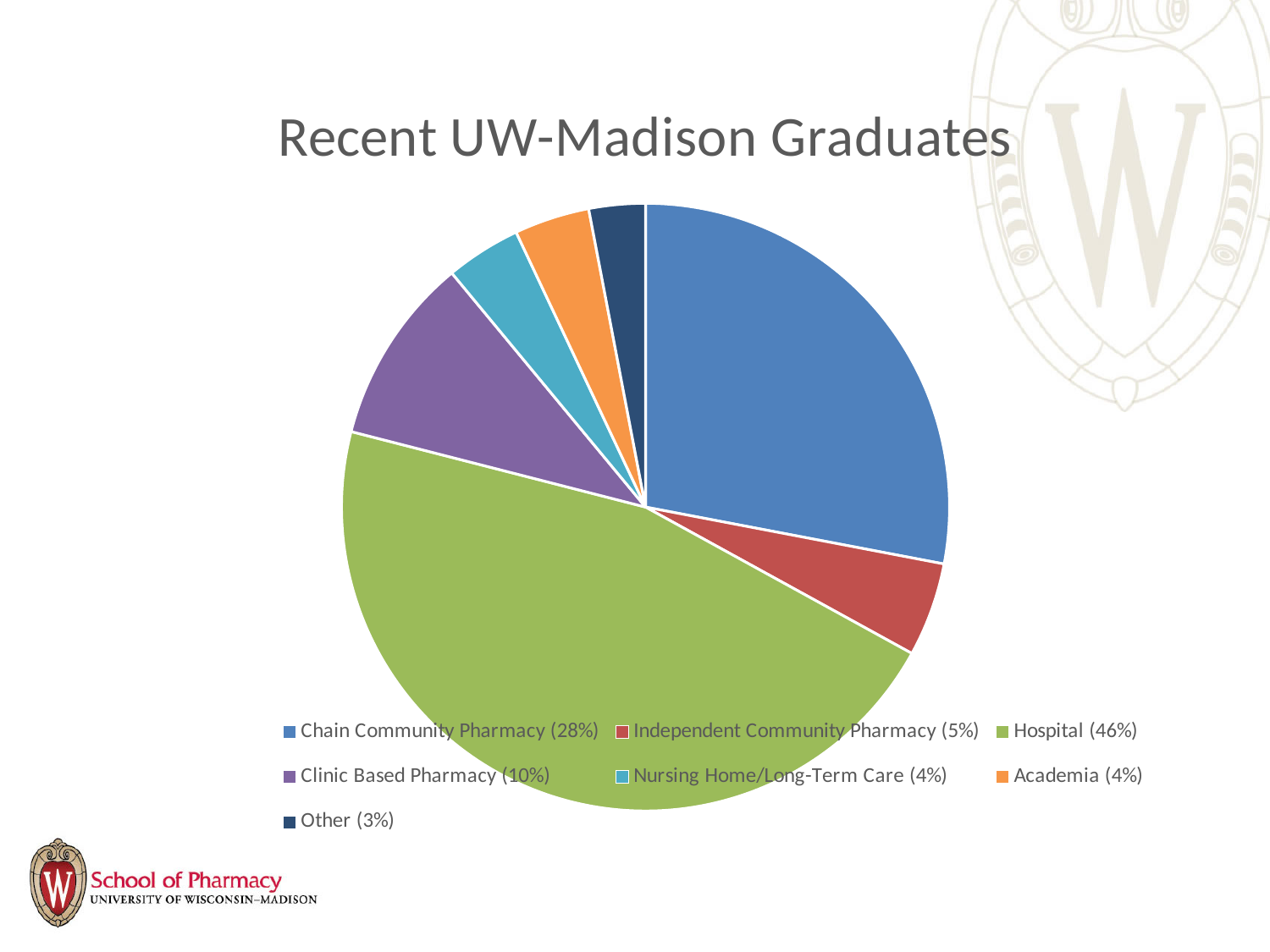
What percentage of recent graduates went into Academia? 4% Which category has the smallest share of the pie? Other What is the difference in percentage points between Hospital and Chain Community Pharmacy? 18 What colour is the Hospital slice in the pie chart? green What kind of chart is shown on the slide? pie chart What percentage of recent graduates went into Hospital pharmacy? 46% How many categories does the pie chart have? 7 What is the title of the chart? Recent UW-Madison Graduates What percentage of recent graduates went into Chain Community Pharmacy? 28% Which category has the largest share of the pie? Hospital What share of the pie is Clinic Based Pharmacy? 10% Which is larger, Independent Community Pharmacy or Clinic Based Pharmacy? Clinic Based Pharmacy